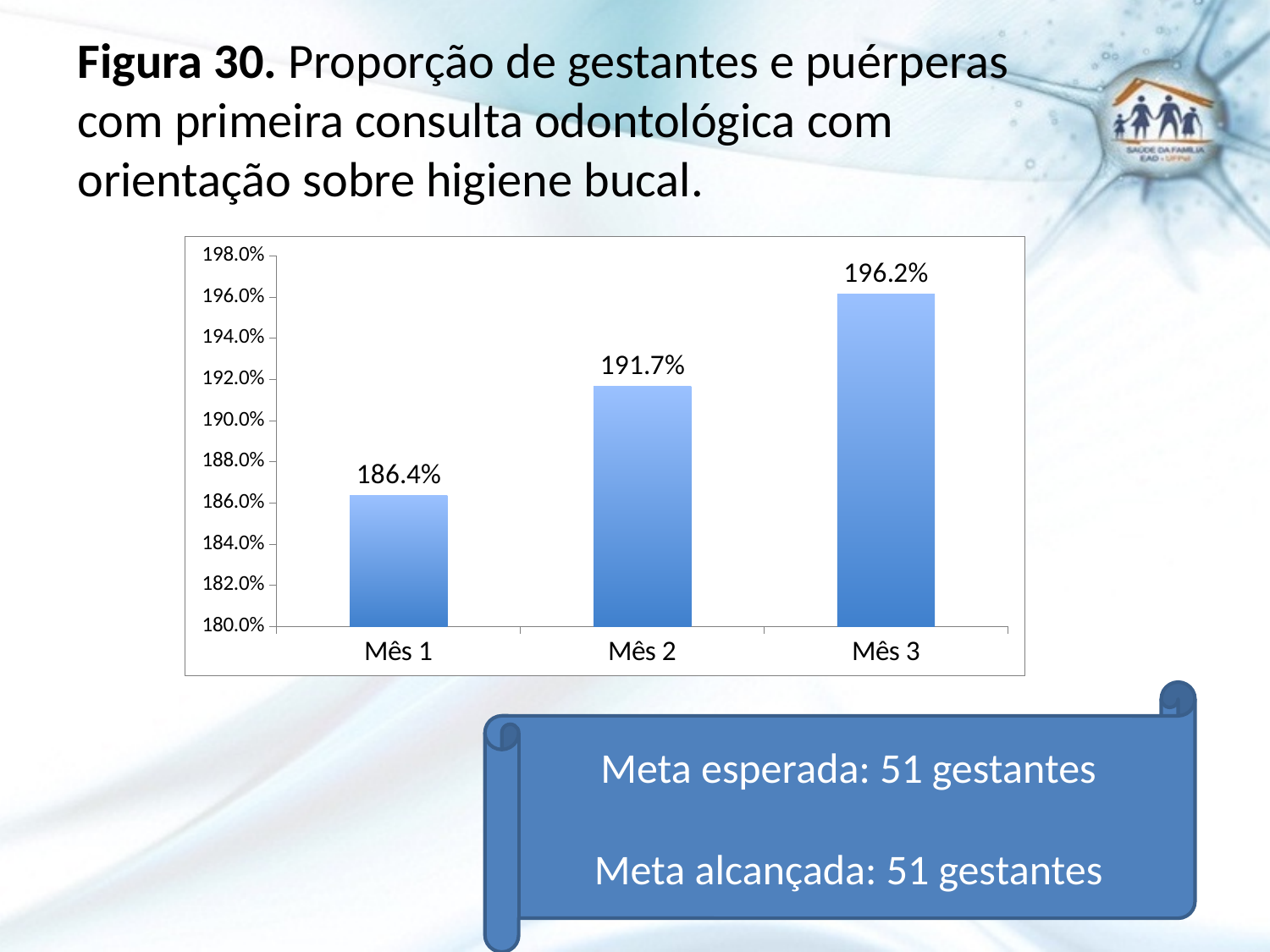
Which is larger, the value for Mês 2 or the value for Mês 3? Mês 3 What is the difference between the values for Mês 3 and Mês 1? 9.8% Is the value for Mês 2 greater or less than 190.0%? greater What is the value for Mês 2? 191.7% What is the difference between the values for Mês 2 and Mês 1? 5.3% Do the values rise or fall from Mês 1 to Mês 3? rise How many categories are shown on the x axis? 3 What is the value for Mês 3? 196.2% Which month has the lowest value? Mês 1 What kind of chart is shown on the slide? bar chart Which month has the highest value? Mês 3 What is the value for Mês 1? 186.4%